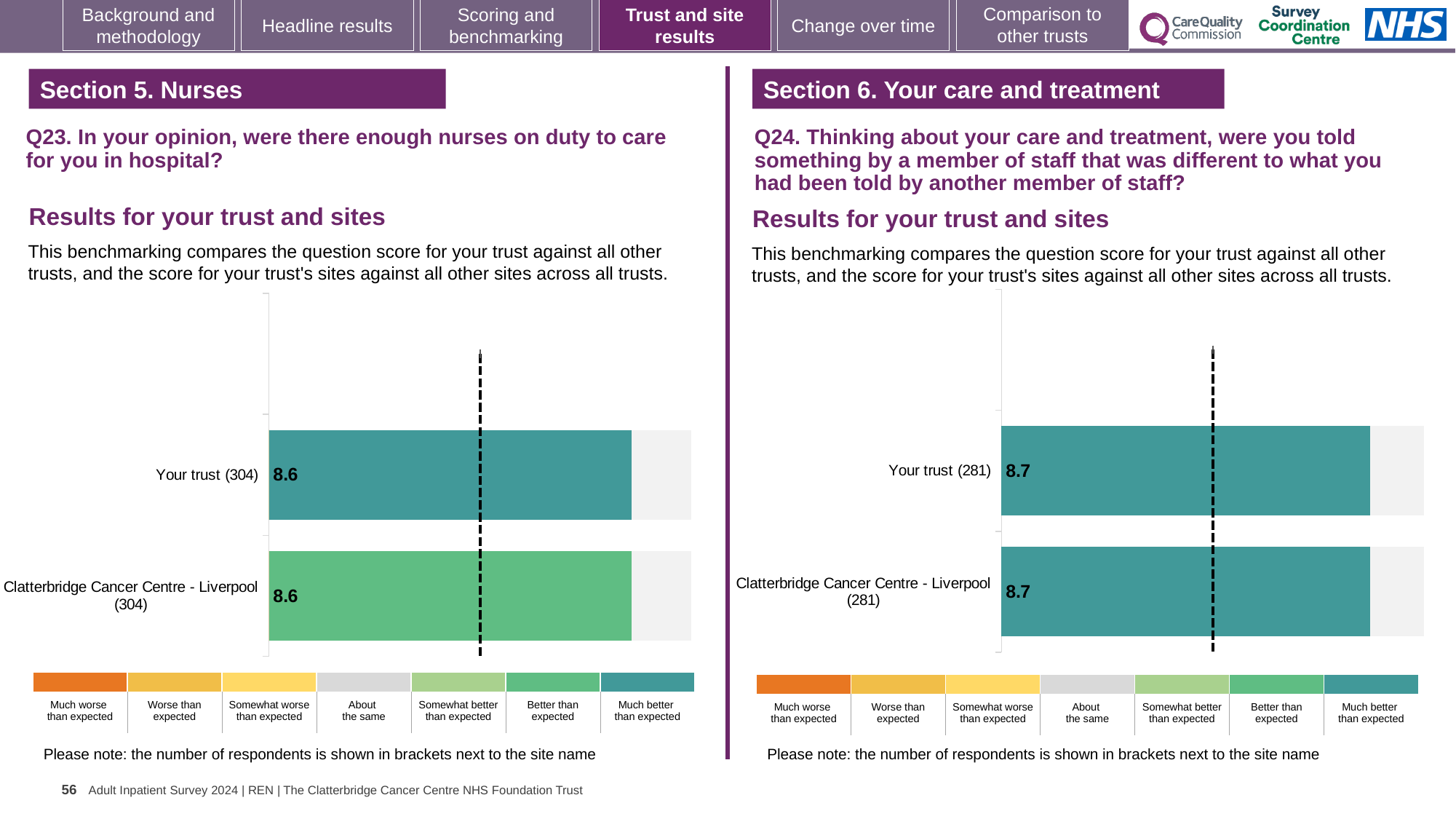
In the Q24 chart on the right, what is the difference between the score for Your trust and the score for Clatterbridge Cancer Centre - Liverpool? 0.0 In the Q23 chart on the left, what is the difference between the score for Your trust and the score for Clatterbridge Cancer Centre - Liverpool? 0.0 Is the score for Your trust in the Q24 chart on the right larger than, smaller than, or equal to the score for Your trust in the Q23 chart on the left? Larger In the Q24 chart on the right, how many respondents are shown in brackets for Clatterbridge Cancer Centre - Liverpool? 281 In the Q23 chart on the left, how many respondents are shown in brackets for Your trust? 304 In the Q23 chart on the left, what is the score for Clatterbridge Cancer Centre - Liverpool? 8.6 In the Q24 chart on the right, what is the score for Clatterbridge Cancer Centre - Liverpool? 8.7 In the Q24 chart on the right, what is the score for Your trust? 8.7 How many bars are plotted in the Q24 chart on the right? 2 How many bars are plotted in the Q23 chart on the left? 2 In the Q23 chart on the left, what is the score for Your trust? 8.6 What kind of chart is the Q23 chart on the left? Bar chart